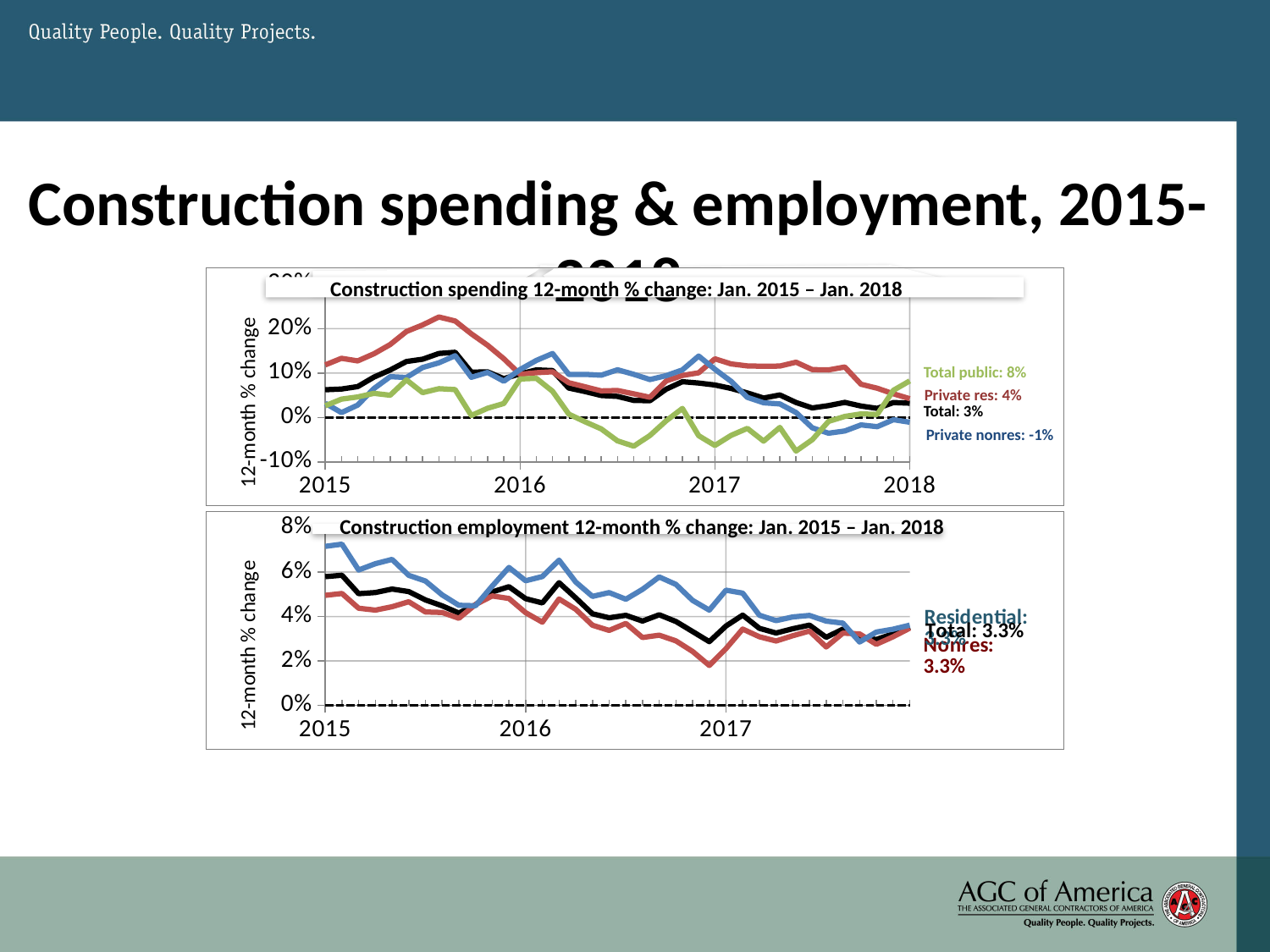
In the top chart (construction spending), which series has the lowest labelled end value? Private nonres How many series are labelled in the top chart (construction spending)? 4 In the top chart (construction spending), what is the latest value labelled for Total? 3% In the top chart (construction spending), what is the latest value labelled for Total public? 8% In the top chart (construction spending), which has the larger labelled end value, Private res or Total? Private res In the top chart (construction spending), is the peak of the Private res line in 2015 greater or less than 20%? greater In the top chart (construction spending), what is the latest value labelled for Private nonres? -1% What kind of chart is the top chart, 'Construction spending 12-month % change: Jan. 2015 – Jan. 2018'? Line chart In the top chart (construction spending), what is the difference between the labelled end values for Total public and Private res? 4 percentage points In the top chart (construction spending), which series has the highest labelled end value? Total public In the bottom chart (construction employment), is the value of the Residential (blue) line at the start of 2015 greater or less than 6%? greater In the bottom chart (construction employment), what is the labelled end value for Total? 3.3%